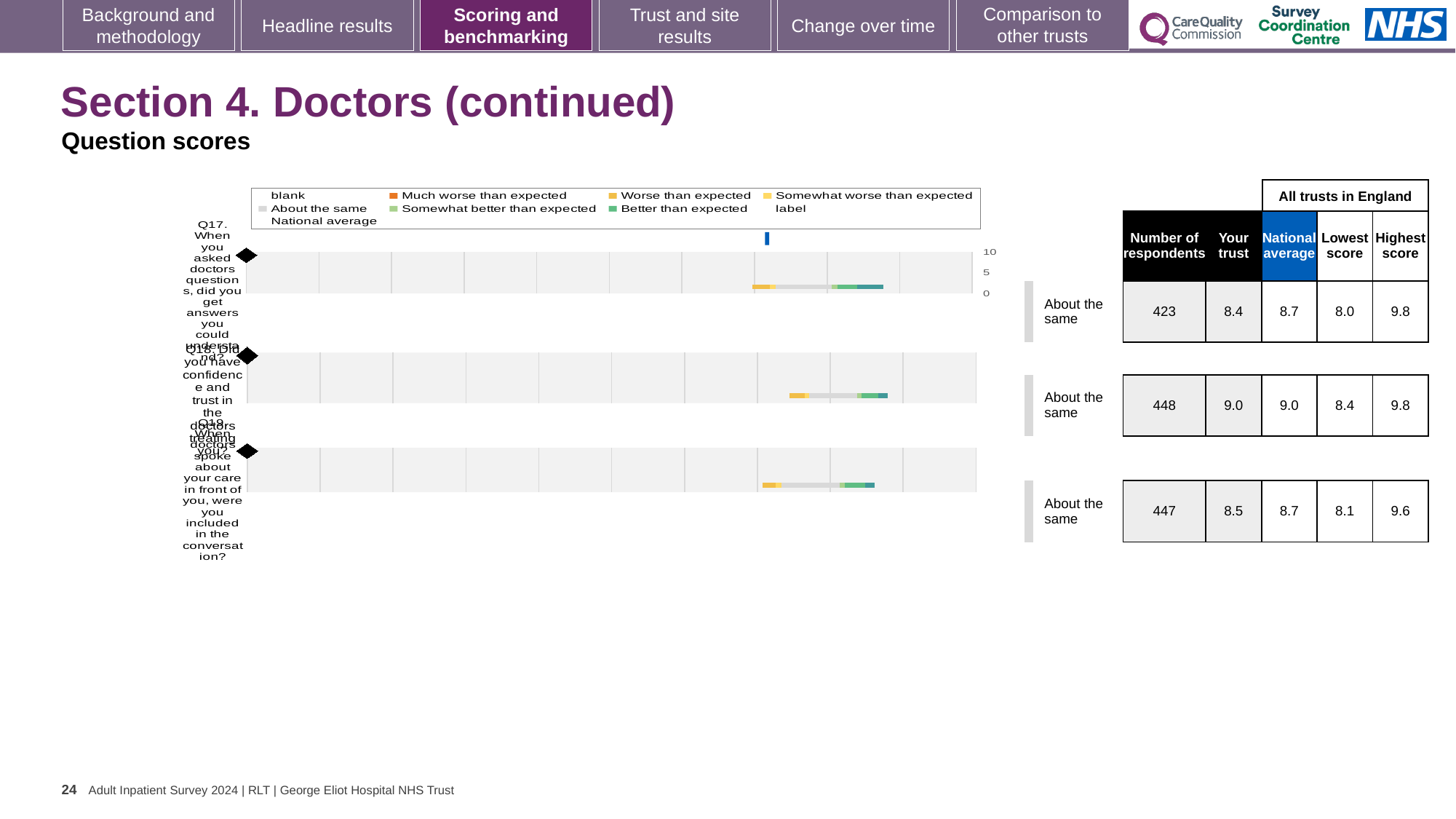
What rating is shown beside the chart row for Q17? About the same In the table beside the chart, what is the difference between the highest score and lowest score for Q19? 1.5 In the table beside the chart, what is the 'Your trust' score for Q18? 9.0 Which legend entry is shown in orange? Much worse than expected In the table beside the chart, is the number of respondents for Q18 larger than for Q17? Yes How many questions (rows) are plotted in the chart? 3 What rating is shown beside the chart row for Q19? About the same In the table beside the chart, what is the national average for Q17? 8.7 What kind of chart is shown on the slide? bar chart How many entries does the chart legend list? 9 In the table beside the chart, which question has the highest 'Your trust' score? Q18 What is the highest value shown on the chart's axis? 10